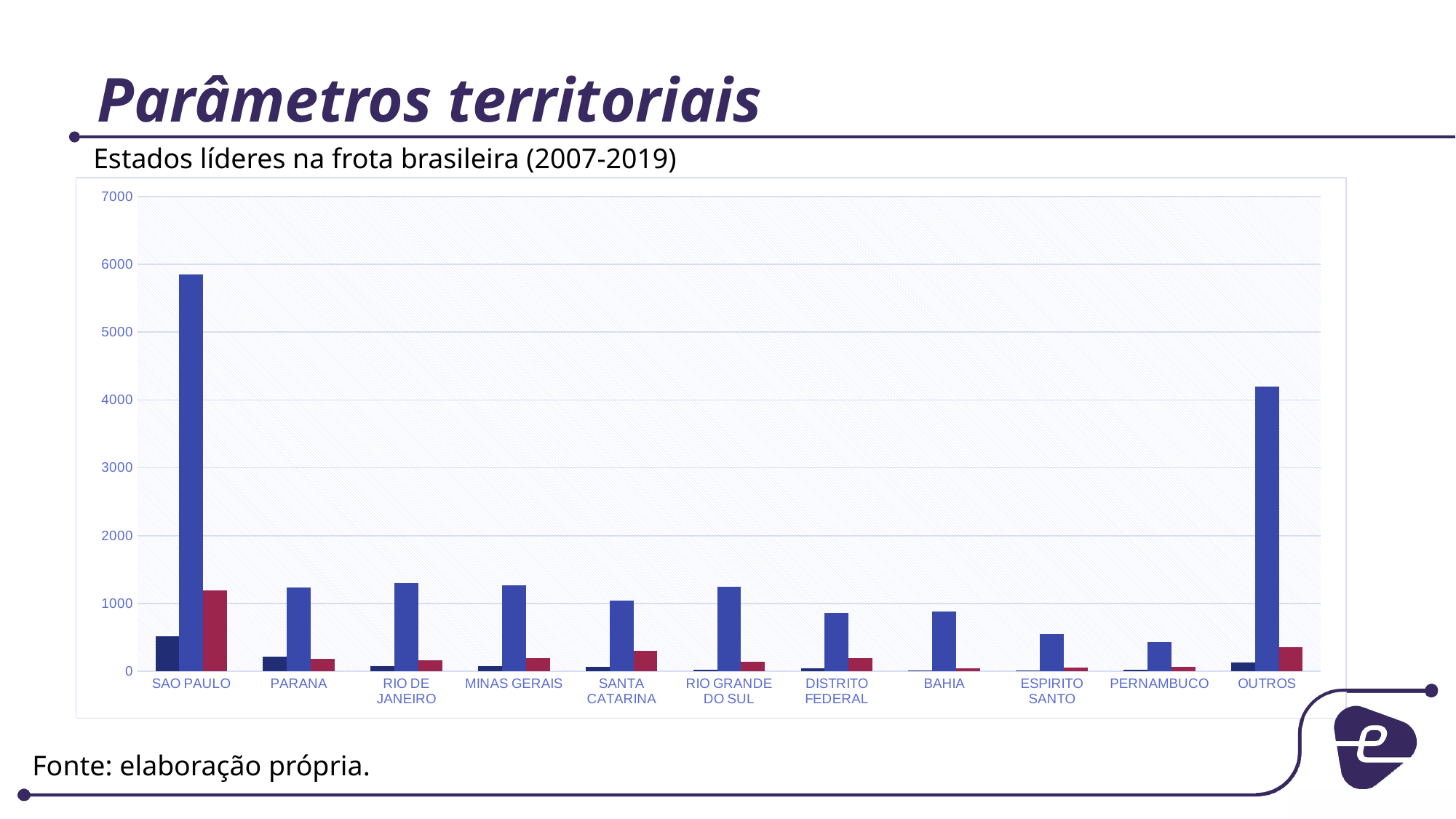
Is the blue bar for SAO PAULO greater or less than 5000? greater What kind of chart is shown on the slide? bar chart Is the blue bar for BAHIA greater or less than 1000? less What is the title of the chart? Estados líderes na frota brasileira (2007-2019) How many categories are shown on the x axis of the chart? 11 Which has the larger blue bar, PARANA or ESPIRITO SANTO? PARANA Is the red bar for SANTA CATARINA greater or less than 1000? less Which has the larger blue bar, SAO PAULO or OUTROS? SAO PAULO Which category has the tallest blue bar? SAO PAULO